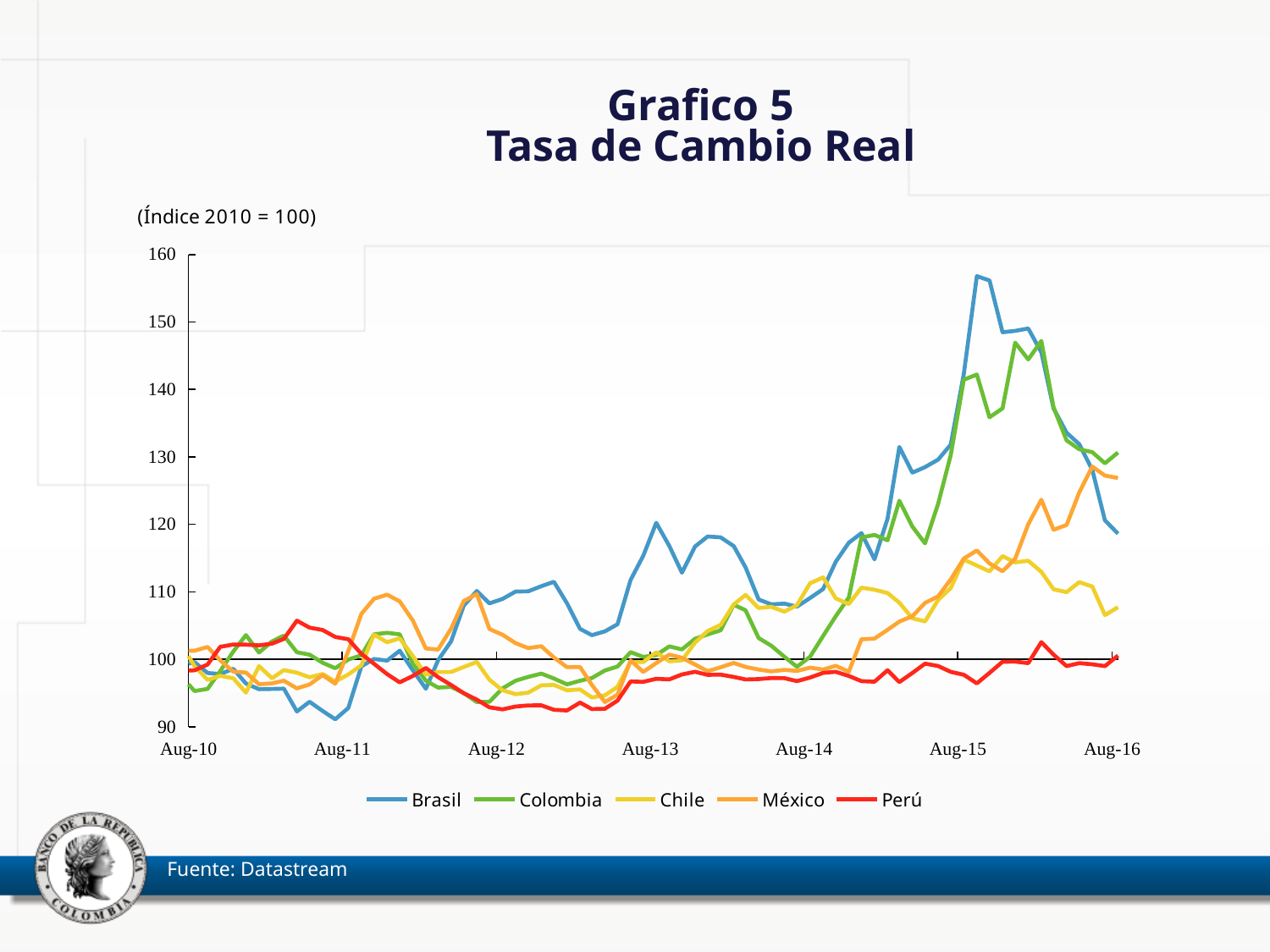
Which series reaches the highest value on the chart? Brasil Does the Brasil series rise or fall between Aug-15 and Aug-16? Fall Is the peak value for Colombia greater or less than 140? greater How many date labels are shown on the x axis? 7 What kind of chart is shown on the slide? Line chart At Aug-16, which is higher: México or Chile? México Is the peak value for Brasil around Aug-15 greater or less than 150? greater Does the Brasil series rise or fall between Aug-14 and Aug-15? Rise How many series does the legend list? 5 Is the value for México at Aug-16 greater or less than 120? greater What is the title of the chart? Grafico 5 Tasa de Cambio Real